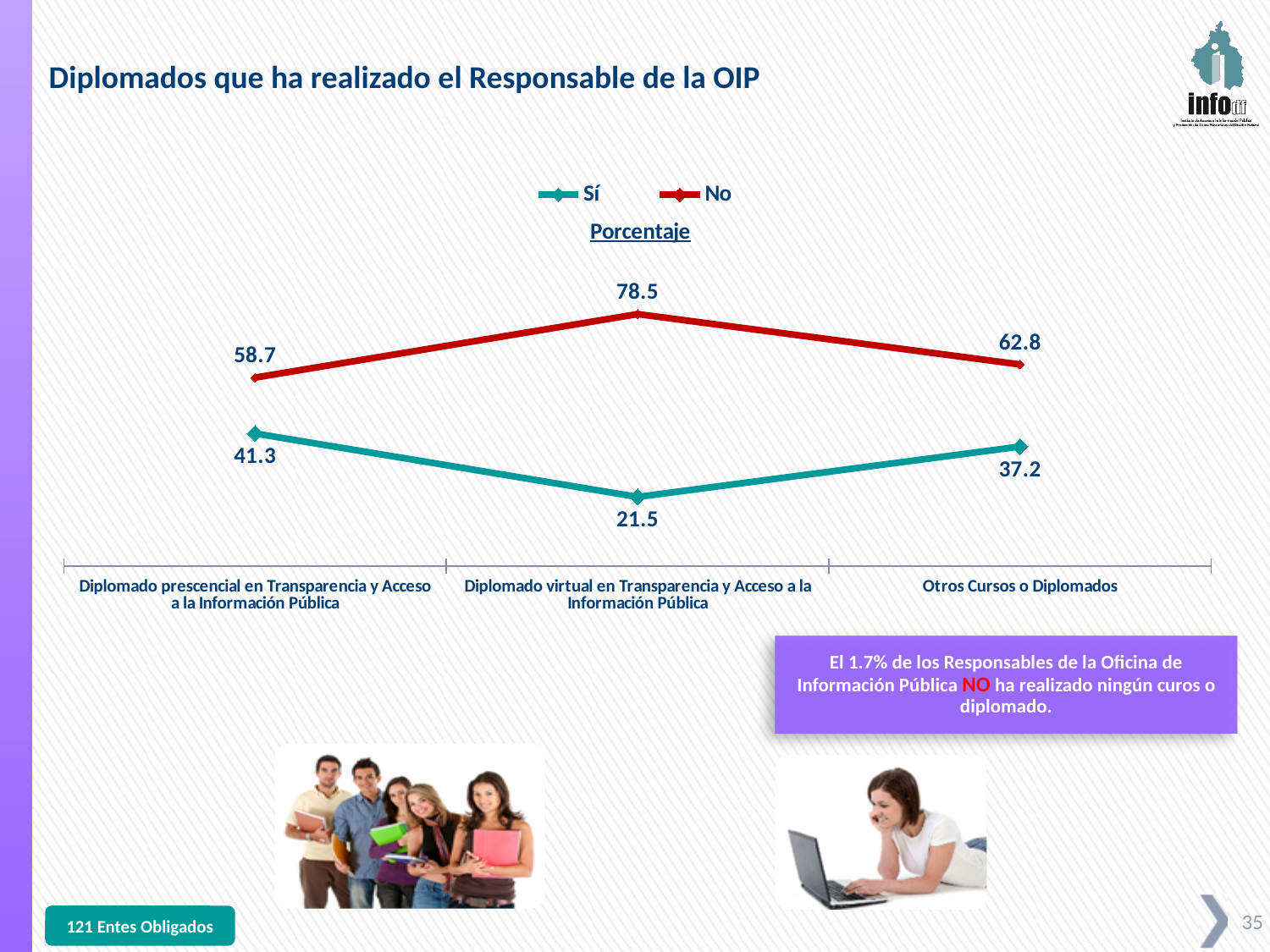
What is the difference between the "No" and "Sí" values for "Diplomado prescencial en Transparencia y Acceso a la Información Pública"? 17.4 What is the value of the "No" series for "Otros Cursos o Diplomados"? 62.8 Which category has the lowest value in the "Sí" series? Diplomado virtual en Transparencia y Acceso a la Información Pública What is the value of the "Sí" series for "Diplomado virtual en Transparencia y Acceso a la Información Pública"? 21.5 What is the value of the "Sí" series for "Diplomado prescencial en Transparencia y Acceso a la Información Pública"? 41.3 Which is larger for "Otros Cursos o Diplomados": the "Sí" value or the "No" value? No Which category has the highest value in the "No" series? Diplomado virtual en Transparencia y Acceso a la Información Pública What colour is the line for the "No" series? Red How many series does the chart legend list? 2 What kind of chart is shown on the slide? Line chart What is the title of the chart? Porcentaje How many categories are shown on the x axis of the chart? 3